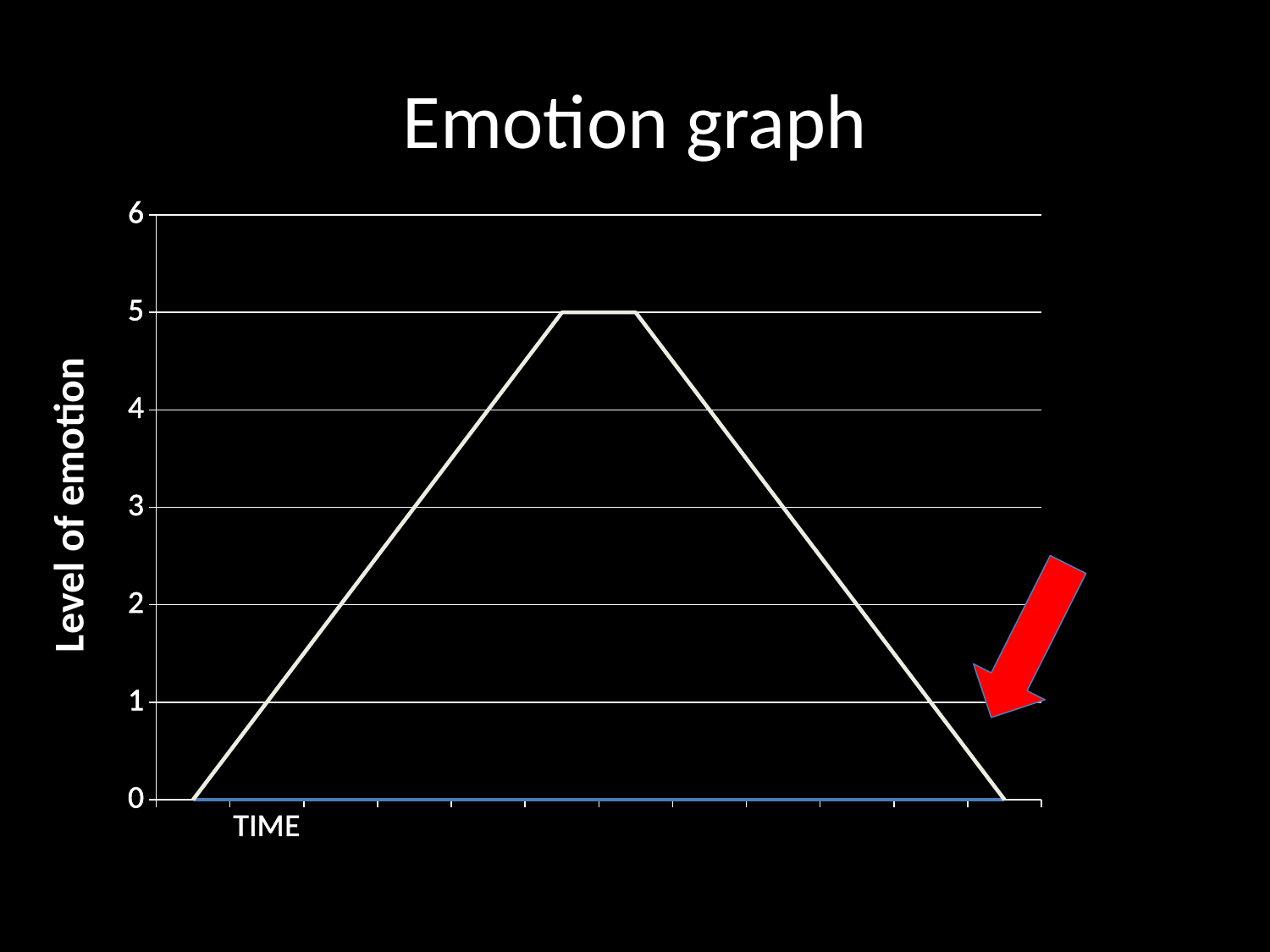
What is the title of the chart? Emotion graph What is the highest value marked on the vertical axis? 6 How does the level of emotion change along the time axis? rises to a peak, then falls What is the highest level of emotion reached by the line? 5 What is the level of emotion at the start of the line, at the left end of the time axis? 0 What is the lowest level of emotion shown by the line? 0 What is the level of emotion at the end of the line, at the right end of the time axis? 0 What kind of chart is shown on the slide? line chart What is the difference between the peak level of emotion and the starting level? 5 Is the peak level of emotion greater or less than 4? greater What is the label on the vertical axis of the chart? Level of emotion Is the peak level of emotion greater or less than 6? less